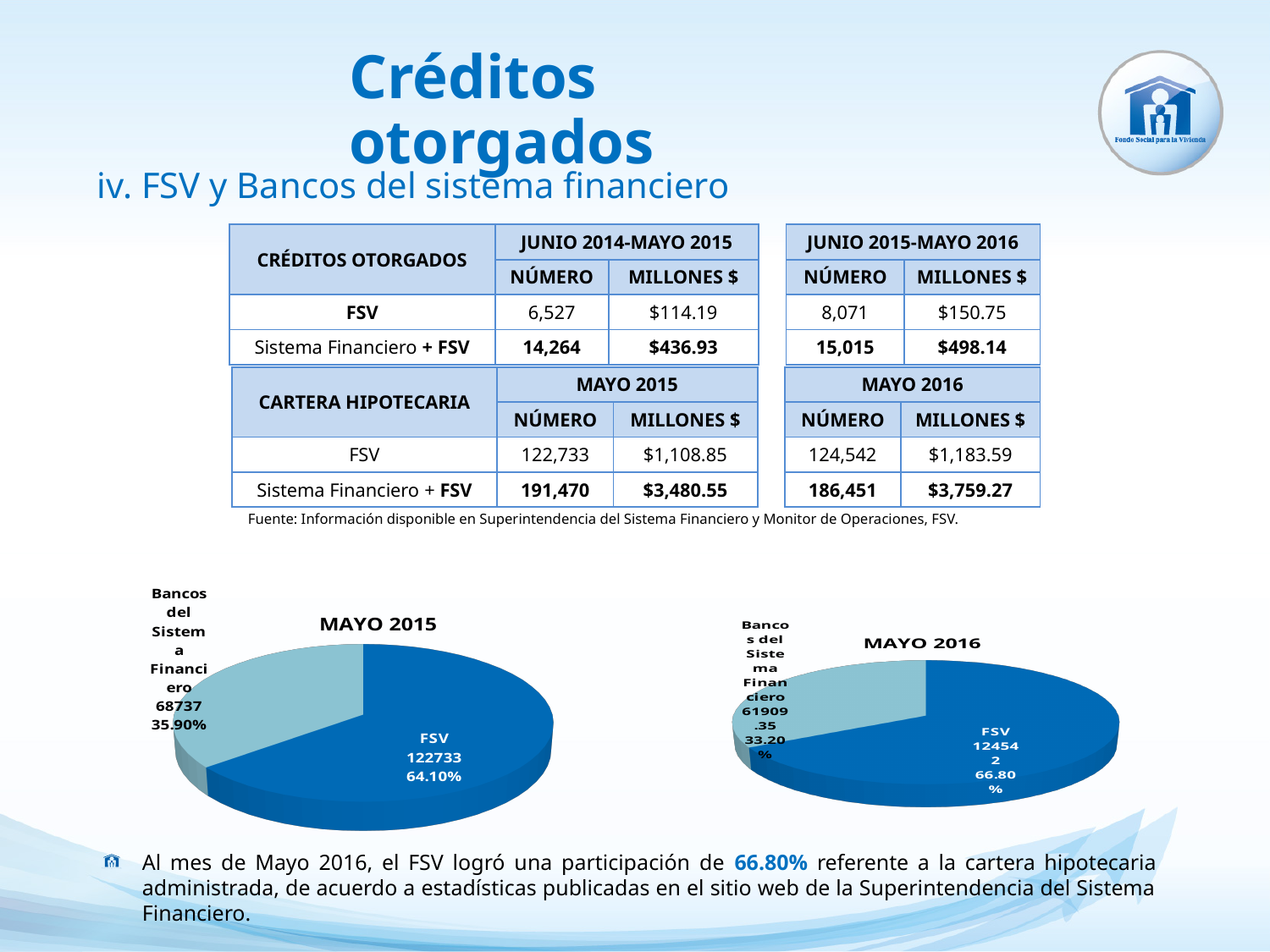
What kind of chart is the MAYO 2015 chart? pie chart In the MAYO 2016 pie chart, which slice is the smallest? Bancos del Sistema Financiero In the MAYO 2015 pie chart, what share does FSV hold? 64.10% In the MAYO 2016 pie chart, what is the value shown for FSV? 124542 In the MAYO 2015 pie chart, what share do Bancos del Sistema Financiero hold? 35.90% In the MAYO 2015 pie chart, which slice is the largest? FSV In the MAYO 2015 pie chart, what is the value shown for Bancos del Sistema Financiero? 68737 In the MAYO 2016 pie chart, what share does FSV hold? 66.80% In the MAYO 2015 pie chart, what is the difference between the FSV value and the Bancos del Sistema Financiero value? 53996 In the MAYO 2015 pie chart, what is the value shown for FSV? 122733 How many slices does the MAYO 2016 pie chart have? 2